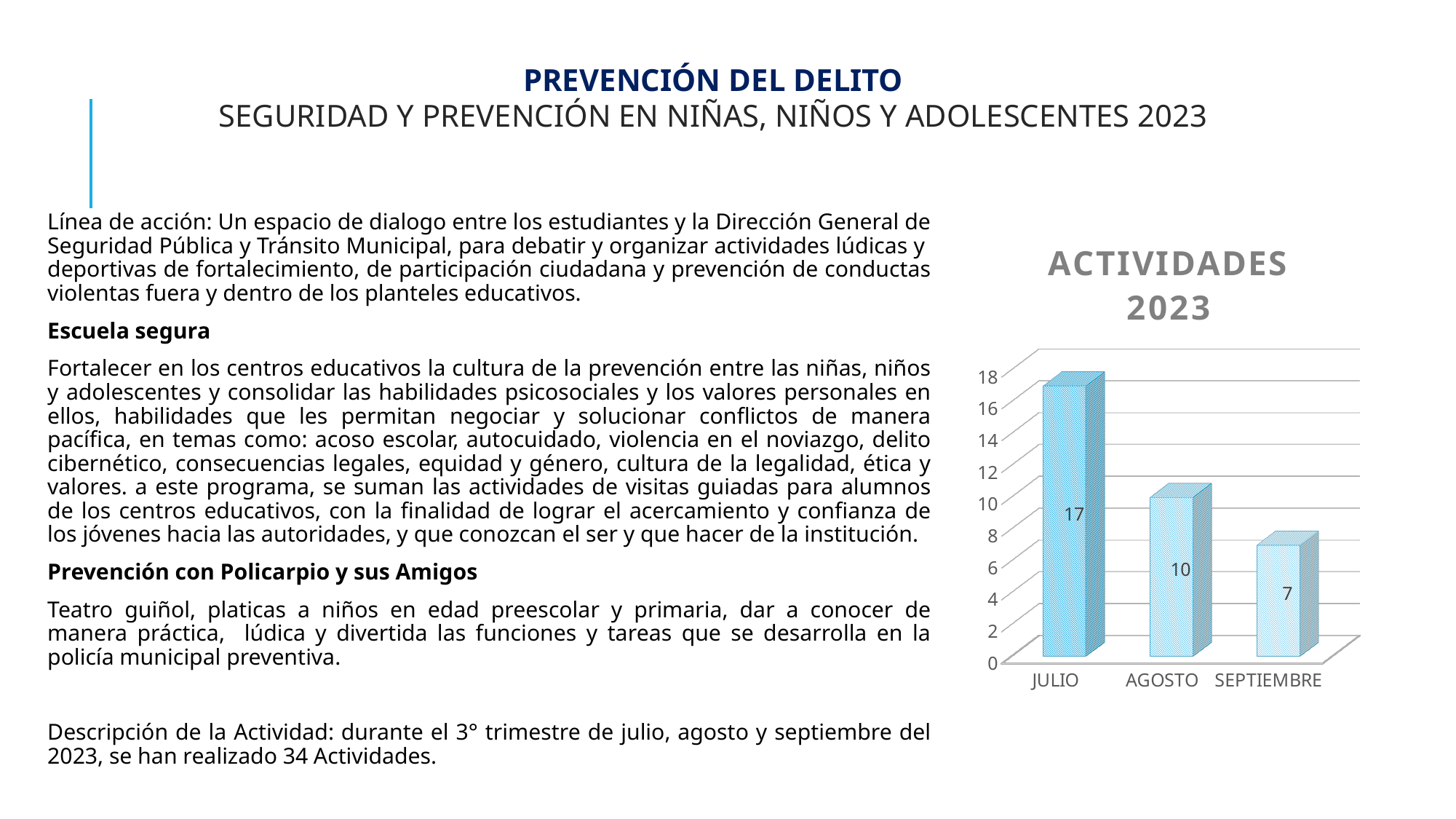
Which is larger in the ACTIVIDADES 2023 chart, the value for JULIO or the value for SEPTIEMBRE? JULIO Which month has the lowest value in the ACTIVIDADES 2023 chart? SEPTIEMBRE Which month has the highest value in the ACTIVIDADES 2023 chart? JULIO What is the value for AGOSTO in the ACTIVIDADES 2023 chart? 10 What is the difference between the values for AGOSTO and SEPTIEMBRE in the ACTIVIDADES 2023 chart? 3 How many categories are shown in the ACTIVIDADES 2023 chart? 3 What kind of chart is the ACTIVIDADES 2023 chart? bar chart What is the value for SEPTIEMBRE in the ACTIVIDADES 2023 chart? 7 What is the title of the chart on the slide? ACTIVIDADES 2023 What is the difference between the values for JULIO and AGOSTO in the ACTIVIDADES 2023 chart? 7 Do the values in the ACTIVIDADES 2023 chart rise or fall from JULIO to SEPTIEMBRE? fall What is the value for JULIO in the ACTIVIDADES 2023 chart? 17